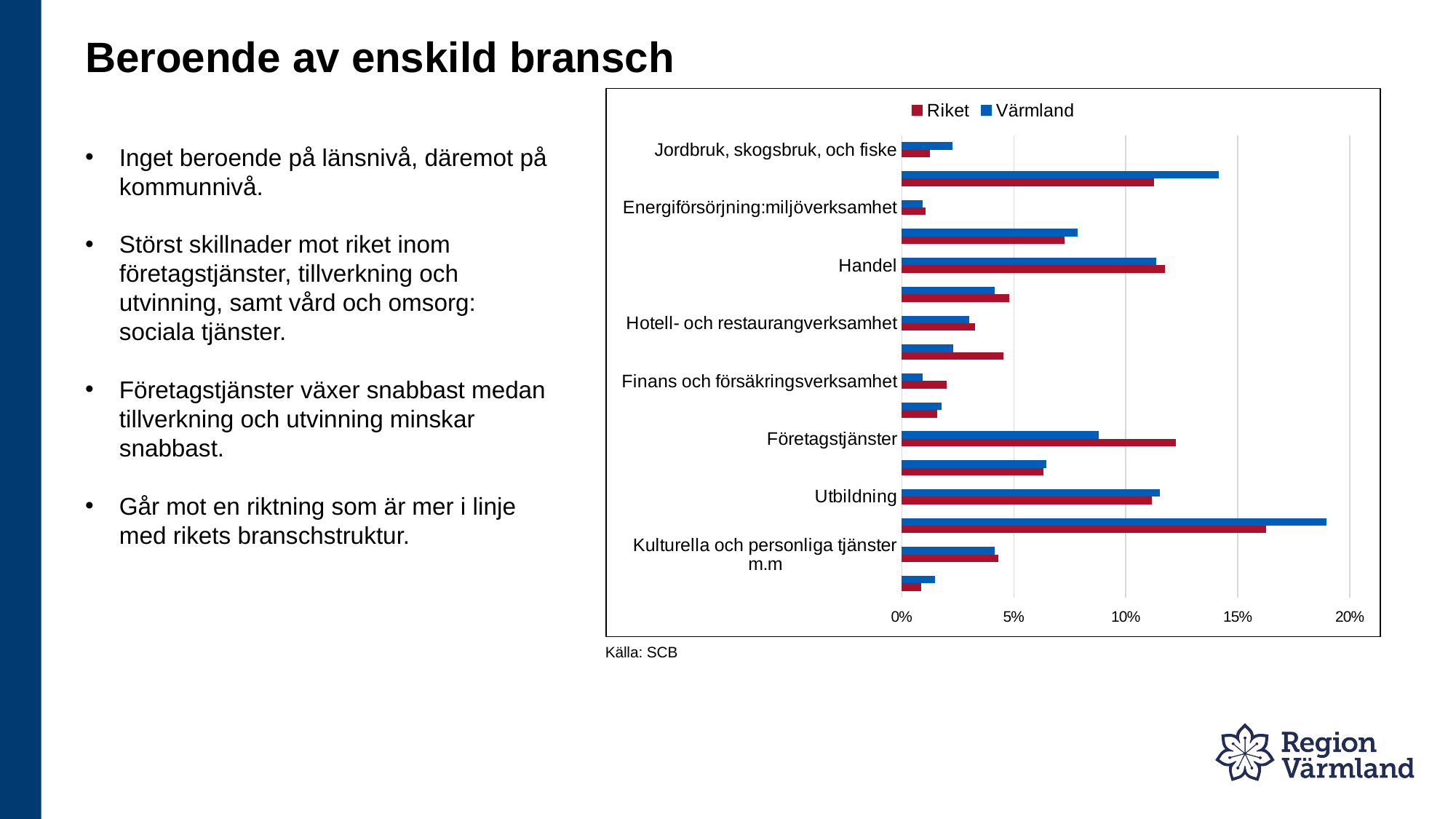
Is the Riket value for Företagstjänster greater or less than 10%? greater Which two series are listed in the chart legend? Riket and Värmland How many series does the chart legend list? 2 Is the Riket value for Handel greater or less than 10%? greater For Jordbruk, skogsbruk, och fiske, which series has the larger value, Riket or Värmland? Värmland For Företagstjänster, which series has the larger value, Riket or Värmland? Riket Is the Riket value for Finans och försäkringsverksamhet greater or less than 5%? less What kind of chart is shown on the slide? bar chart What source is cited below the chart? SCB For Finans och försäkringsverksamhet, which series has the larger value, Riket or Värmland? Riket